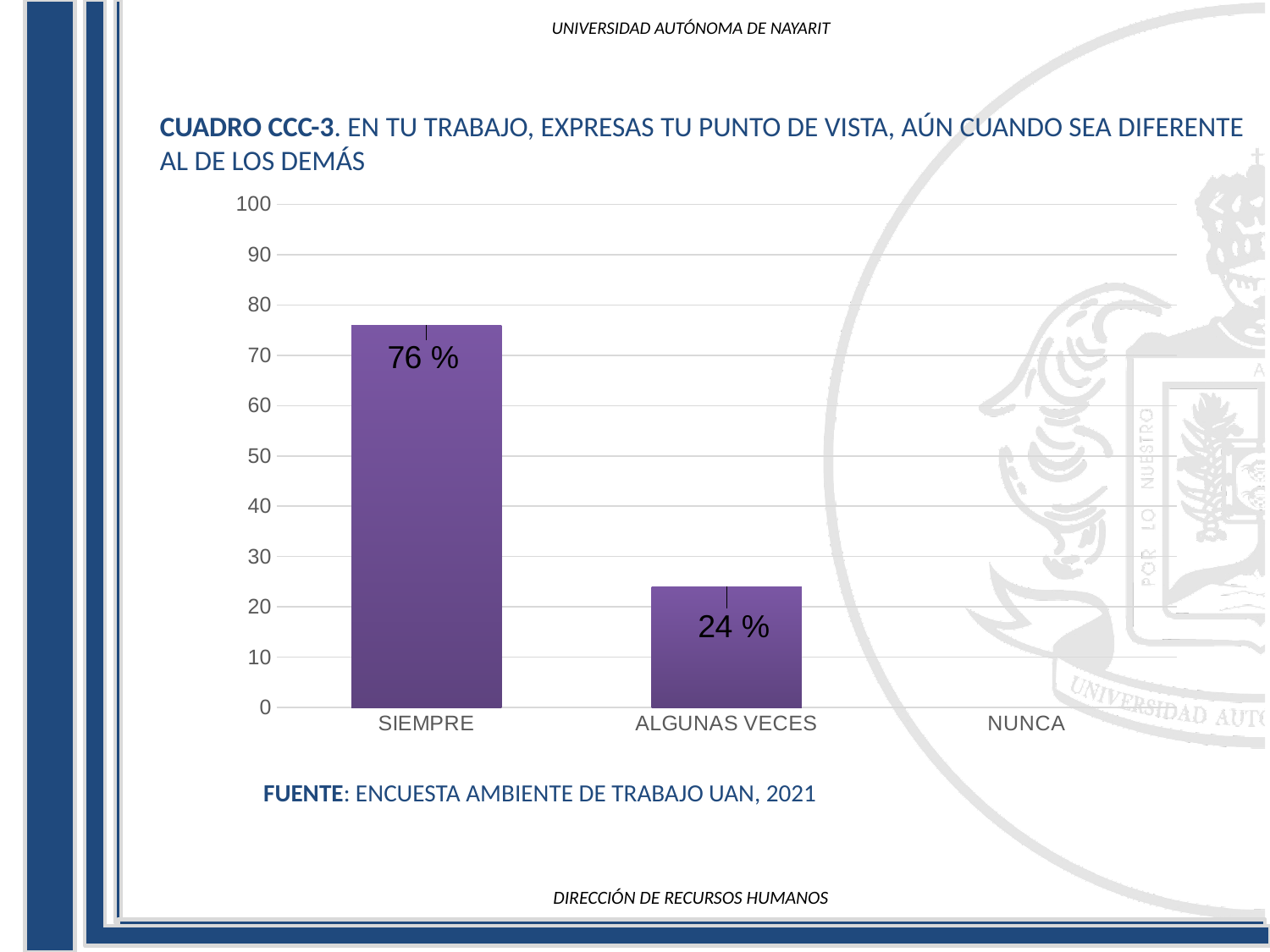
Is the value for ALGUNAS VECES greater or less than 30? less How many categories are shown on the x axis? 3 Is the value for SIEMPRE greater or less than 70? greater What is the source cited below the chart? ENCUESTA AMBIENTE DE TRABAJO UAN, 2021 What is the value for SIEMPRE? 76 % Which category has the highest value? SIEMPRE What is the difference between the values for SIEMPRE and ALGUNAS VECES? 52 % What is the value for ALGUNAS VECES? 24 % Which is larger, the value for SIEMPRE or the value for ALGUNAS VECES? SIEMPRE Do the values rise or fall from left to right along the x axis? Fall What kind of chart is shown on the slide? Bar chart